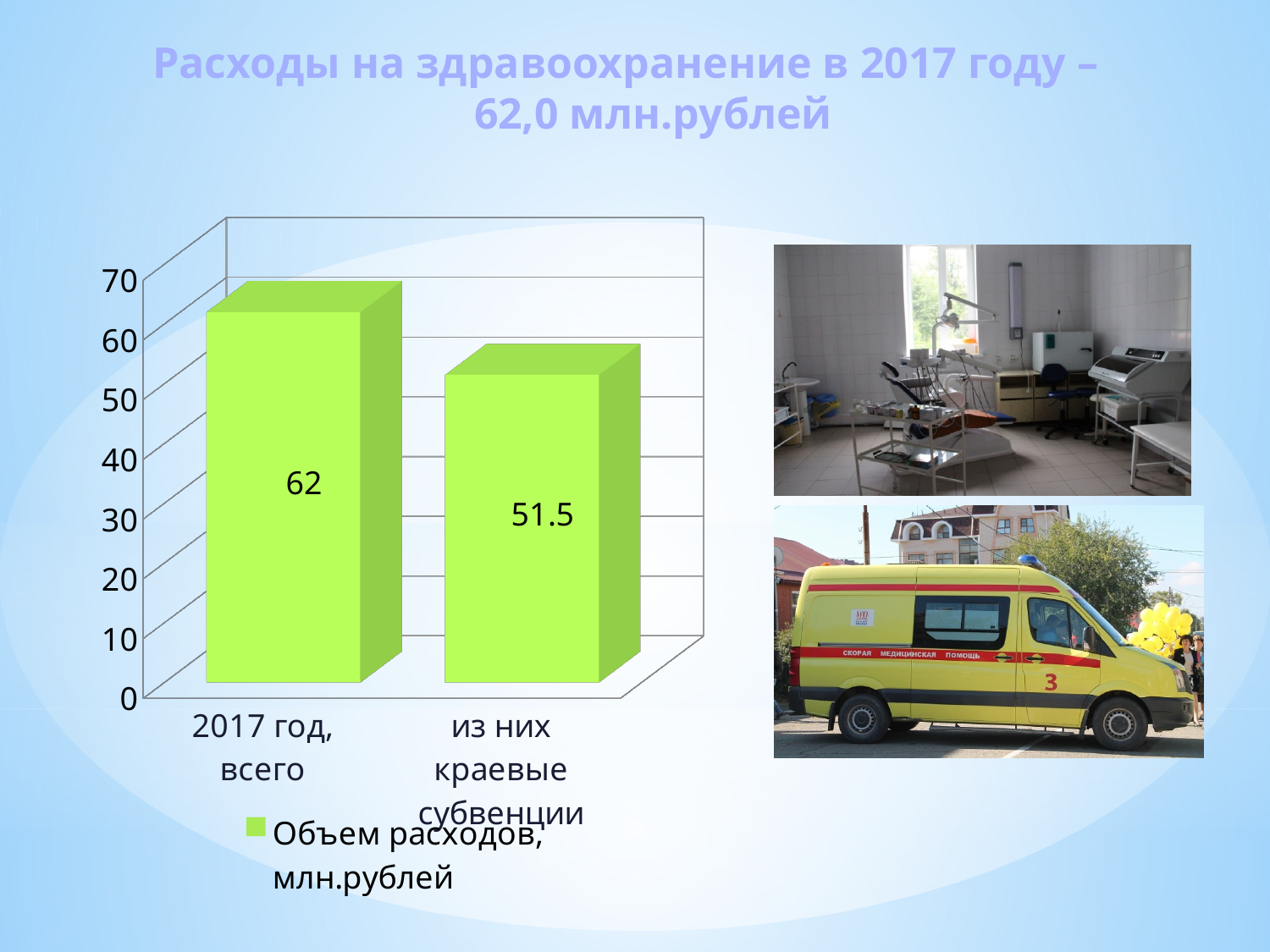
What colour are the bars on the chart? green Which category has the highest value? 2017 год, всего What is the legend entry of the series shown on the chart? Объем расходов, млн.рублей Which category has the lowest value? из них краевые субвенции Is the value for "из них краевые субвенции" greater or less than 60? less How many series does the legend list? 1 What is the value for "2017 год, всего"? 62 Which is larger: the value for "2017 год, всего" or the value for "из них краевые субвенции"? 2017 год, всего What is the value for "из них краевые субвенции"? 51.5 What kind of chart is shown on the slide? bar chart What is the difference between the value for "2017 год, всего" and the value for "из них краевые субвенции"? 10.5 How many categories are shown on the chart? 2